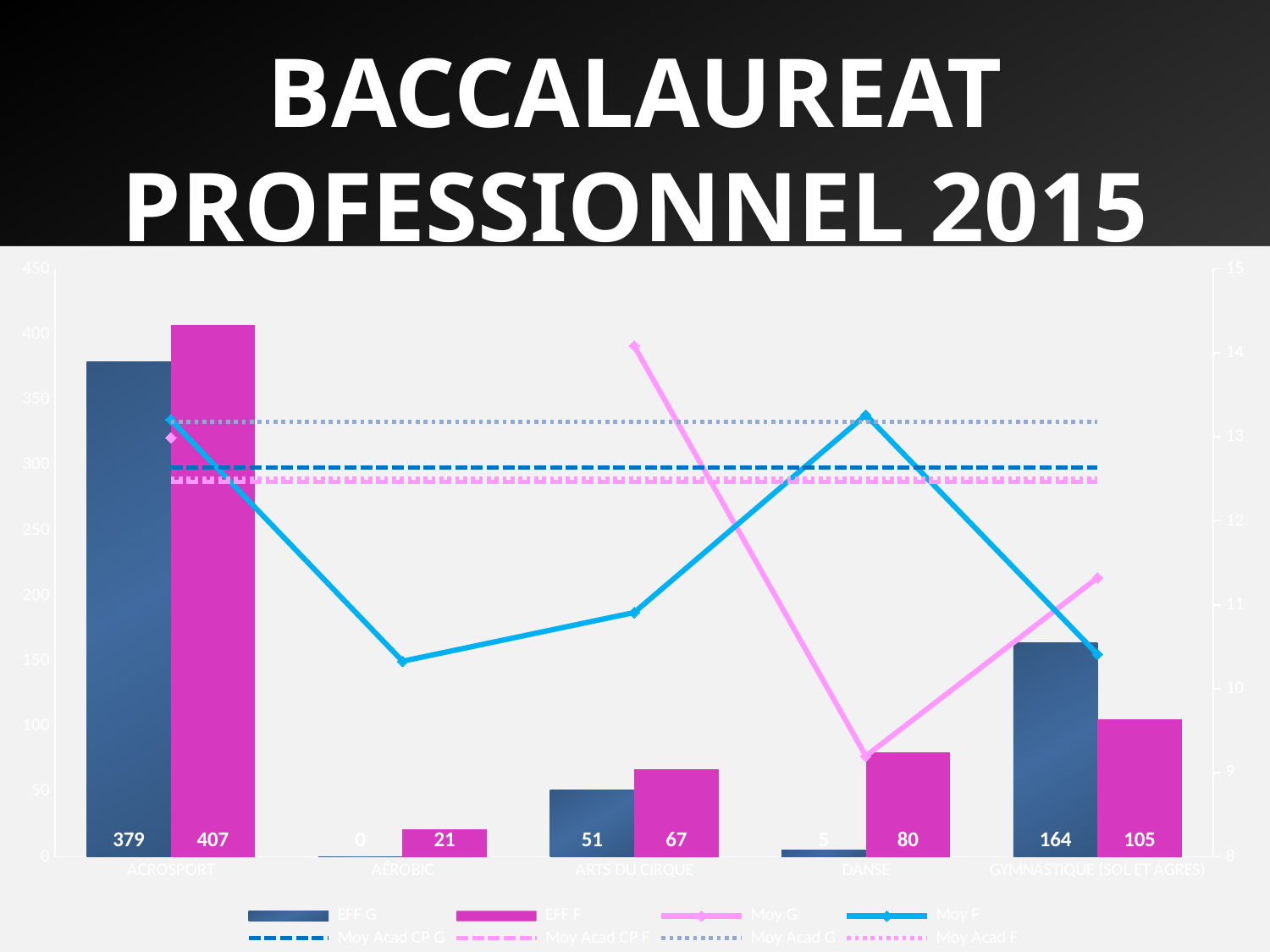
Is the Moy F value for AÉROBIC greater or less than 11 on the right axis? less Which is larger for GYMNASTIQUE (SOL ET AGRES): EFF G or EFF F? EFF G How many series does the legend list? 8 Which category has the lowest EFF G value? AÉROBIC What is the EFF G value for GYMNASTIQUE (SOL ET AGRES)? 164 What is the EFF F value for DANSE? 80 How many categories are shown on the x axis? 5 What is the EFF F value for ACROSPORT? 407 Which category has the highest EFF F value? ACROSPORT What is the EFF G value for AÉROBIC? 0 What is the total of the EFF G and EFF F values for ARTS DU CIRQUE? 118 What is the difference between the EFF F and EFF G values for ACROSPORT? 28